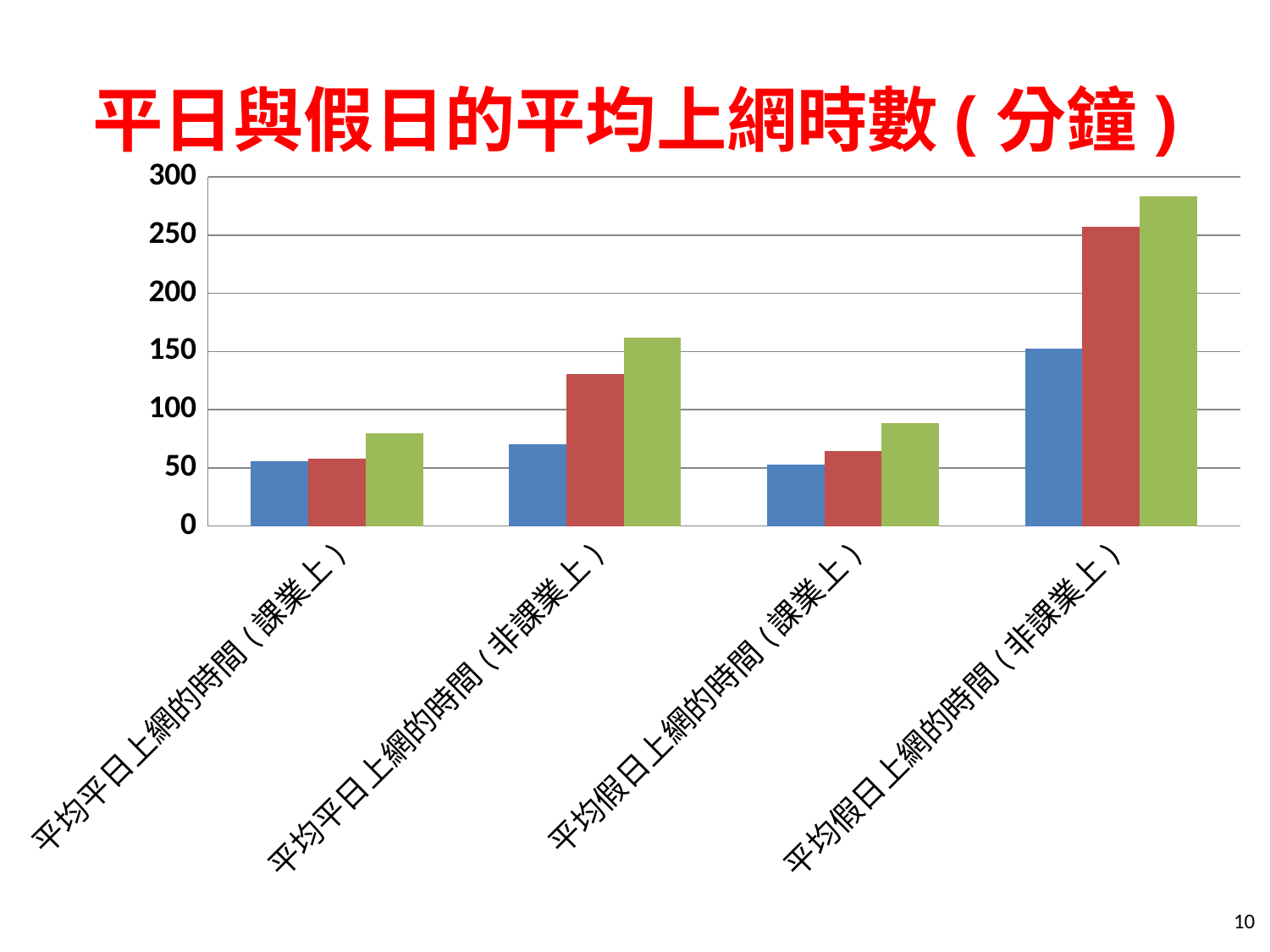
What kind of chart is shown on the slide? bar chart Is the green bar for 平均平日上網的時間(課業上) greater or less than 100? less Is the blue bar for 平均平日上網的時間(課業上) greater or less than 100? less Is the blue bar for 平均假日上網的時間(非課業上) greater or less than 100? greater How many categories are shown on the x axis of the chart? 4 How many bars are plotted for each category in the chart? 3 What is the title of the chart? 平日與假日的平均上網時數(分鐘) Which category has the taller green bar: 平均平日上網的時間(非課業上) or 平均假日上網的時間(課業上)? 平均平日上網的時間(非課業上) In the category 平均假日上網的時間(非課業上), which bar is taller: the red bar or the green bar? the green bar Which category has the tallest bar in the chart? 平均假日上網的時間(非課業上)